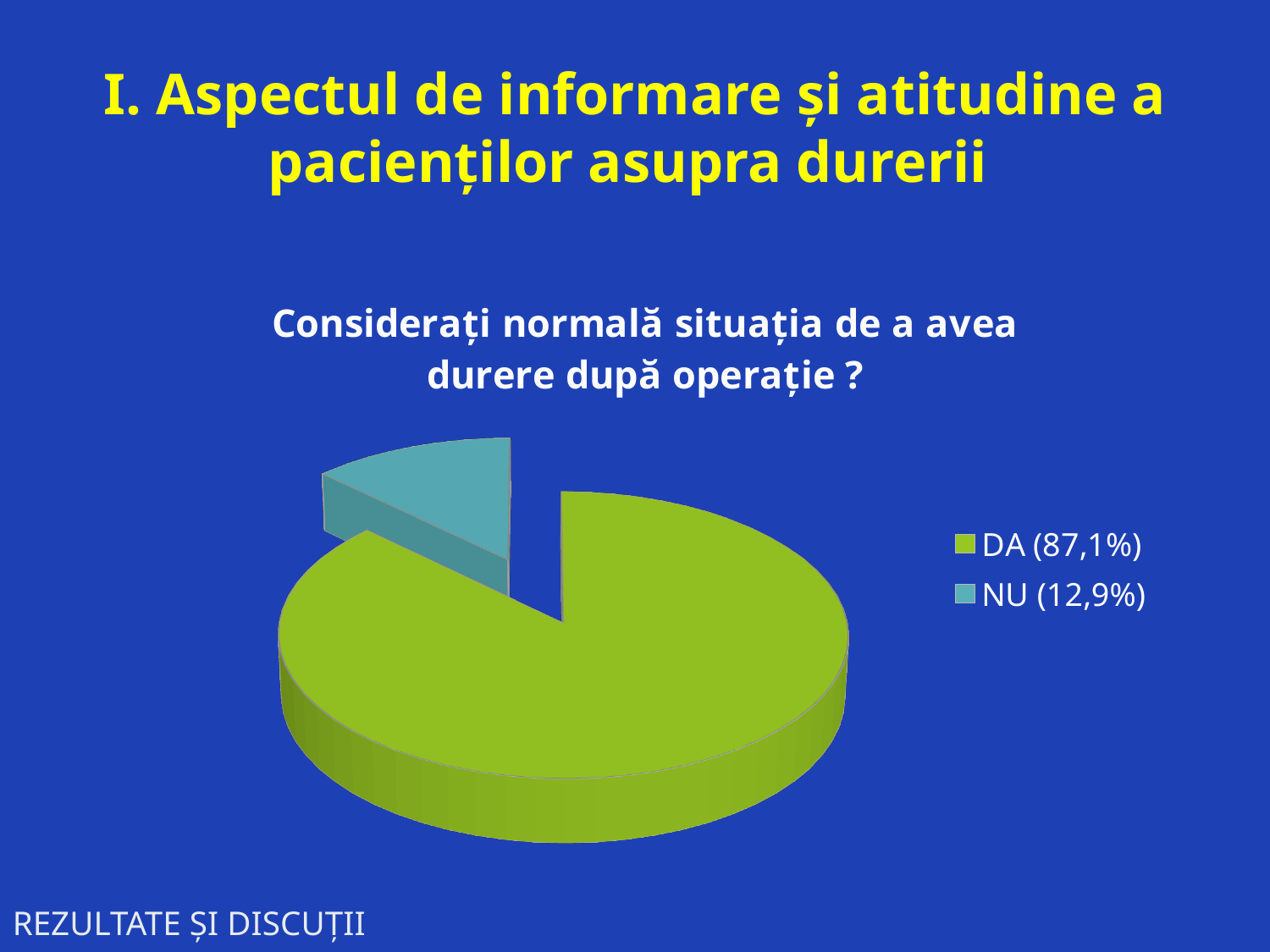
How many slices does the pie chart have? 2 Which slice is the smallest? NU What share of the pie does the DA slice represent? 87,1% What is the difference in percentage points between the DA and NU slices? 74,2 What colour is the DA slice? green What share of the pie does the NU slice represent? 12,9% What is the chart's title? Considerați normală situația de a avea durere după operație ? How many entries does the legend list? 2 What kind of chart is shown on the slide? pie chart Which is larger, the DA slice or the NU slice? DA Which slice is the largest? DA